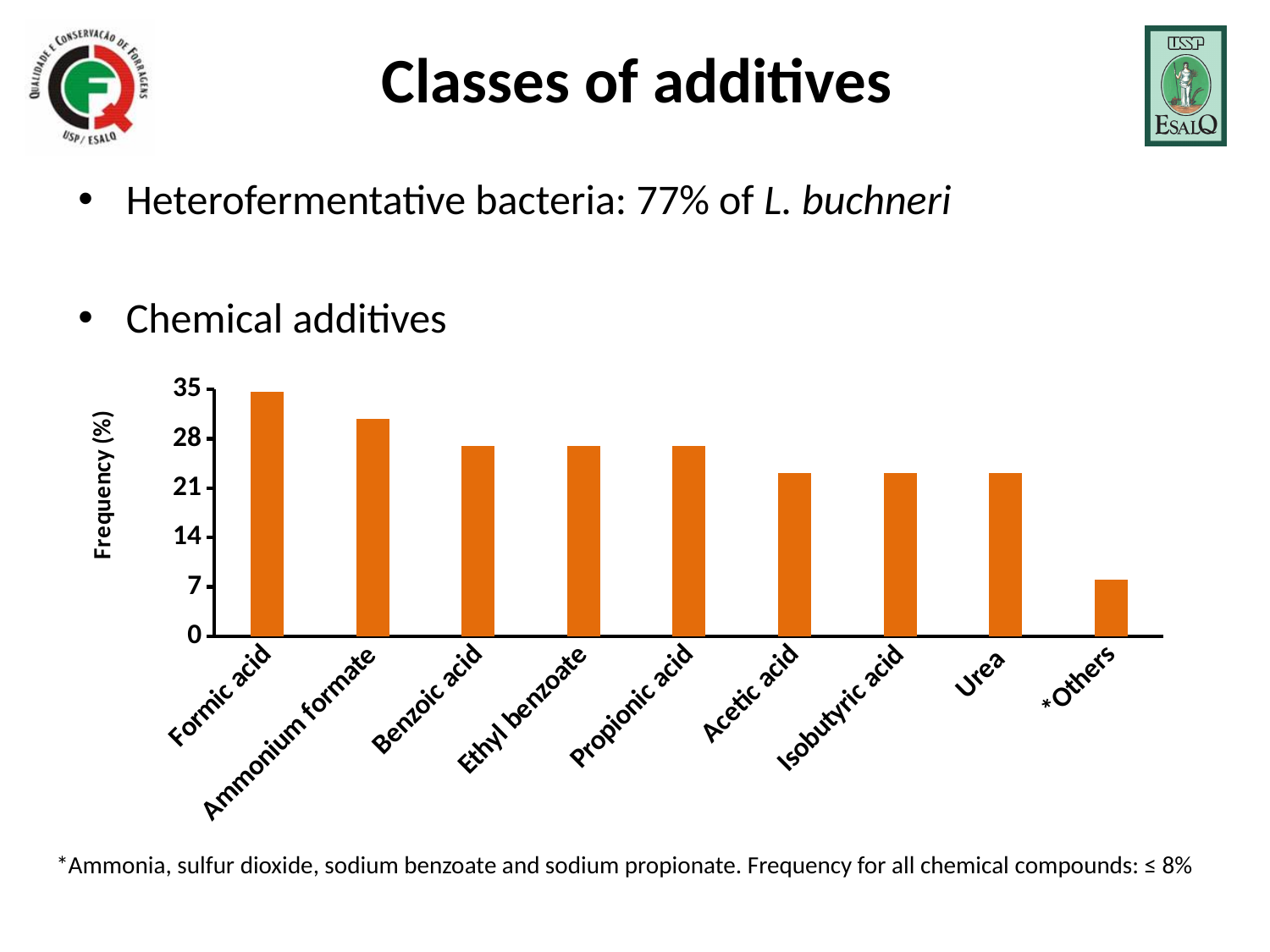
How many categories are plotted on the x axis? 9 What kind of chart is shown on the slide? bar chart Is the frequency for Formic acid greater or less than 28? greater Is the frequency for Ammonium formate greater or less than 28? greater Do the bar values rise or fall from left to right along the x axis? fall What is the label of the y axis? Frequency (%) Which category has the lowest frequency? *Others Which chemical additive has the highest frequency? Formic acid Is the frequency for *Others greater or less than 14? less Which has a higher frequency, Formic acid or Ammonium formate? Formic acid